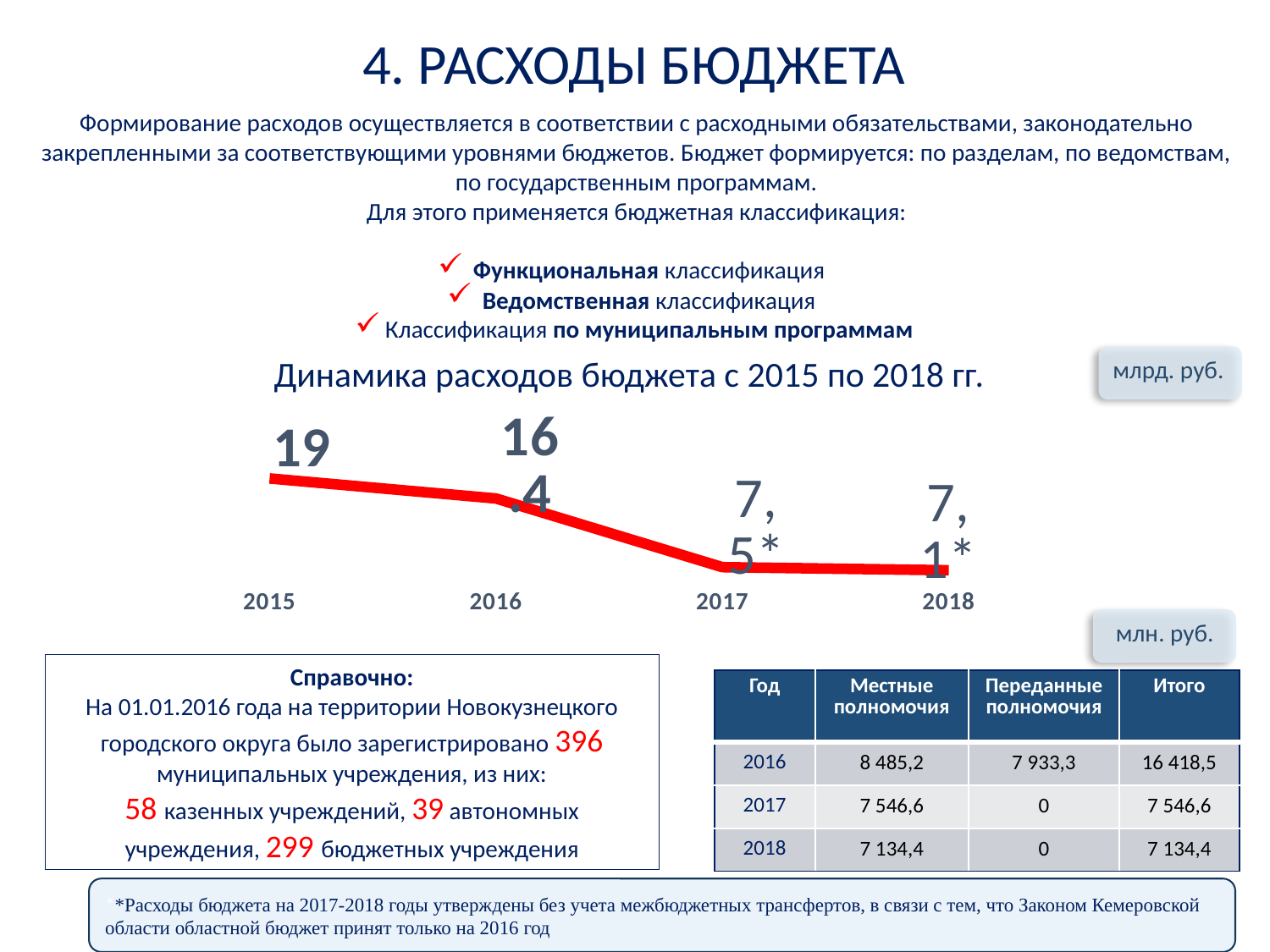
Which year has the highest value in the chart 'Динамика расходов бюджета с 2015 по 2018 гг.'? 2015 What is the value for 2016 in the chart 'Динамика расходов бюджета с 2015 по 2018 гг.'? 16.4 What is the title of the line chart on the slide? Динамика расходов бюджета с 2015 по 2018 гг. What is the value for 2015 in the chart 'Динамика расходов бюджета с 2015 по 2018 гг.'? 19 How many years are plotted in the chart 'Динамика расходов бюджета с 2015 по 2018 гг.'? 4 In the chart 'Динамика расходов бюджета с 2015 по 2018 гг.', which year has the larger value, 2017 or 2018? 2017 In what units are the values of the line chart given, according to the label next to it? млрд. руб. Do the values in the chart 'Динамика расходов бюджета с 2015 по 2018 гг.' rise or fall from 2015 to 2018? fall In the chart 'Динамика расходов бюджета с 2015 по 2018 гг.', by how much does the value for 2015 exceed the value for 2016? 2.6 What kind of chart is used to show the dynamics of budget expenditures from 2015 to 2018? line chart Which year has the lowest value in the chart 'Динамика расходов бюджета с 2015 по 2018 гг.'? 2018 In the chart 'Динамика расходов бюджета с 2015 по 2018 гг.', which year has the larger value, 2016 or 2017? 2016